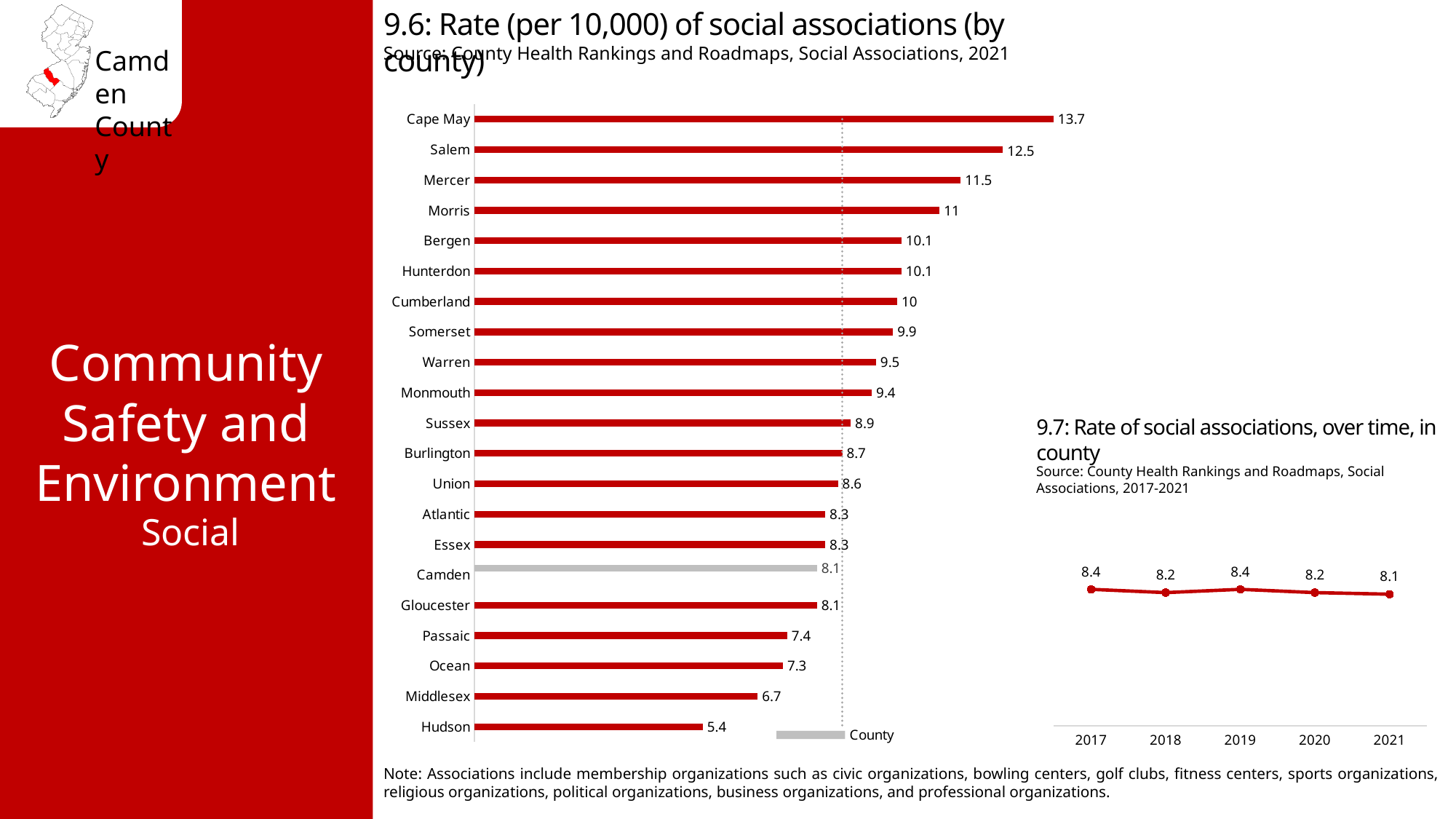
In the chart '9.7: Rate of social associations, over time, in county', what is the value for 2021? 8.1 What kind of chart is '9.6: Rate (per 10,000) of social associations (by county)'? Bar chart In the chart '9.6: Rate (per 10,000) of social associations (by county)', which county has the lowest rate? Hudson In the chart '9.6: Rate (per 10,000) of social associations (by county)', which has a higher value, Mercer or Morris? Mercer In the chart '9.6: Rate (per 10,000) of social associations (by county)', what is the value for Cape May? 13.7 What kind of chart is '9.7: Rate of social associations, over time, in county'? Line chart In the chart '9.6: Rate (per 10,000) of social associations (by county)', what is the difference between the values for Salem and Middlesex? 5.8 In the chart '9.7: Rate of social associations, over time, in county', what is the value for 2019? 8.4 How many counties are shown in the chart '9.6: Rate (per 10,000) of social associations (by county)'? 21 In the chart '9.6: Rate (per 10,000) of social associations (by county)', which county has the highest rate? Cape May How many data points are plotted in the chart '9.7: Rate of social associations, over time, in county'? 5 In the chart '9.6: Rate (per 10,000) of social associations (by county)', what is the value for Camden? 8.1